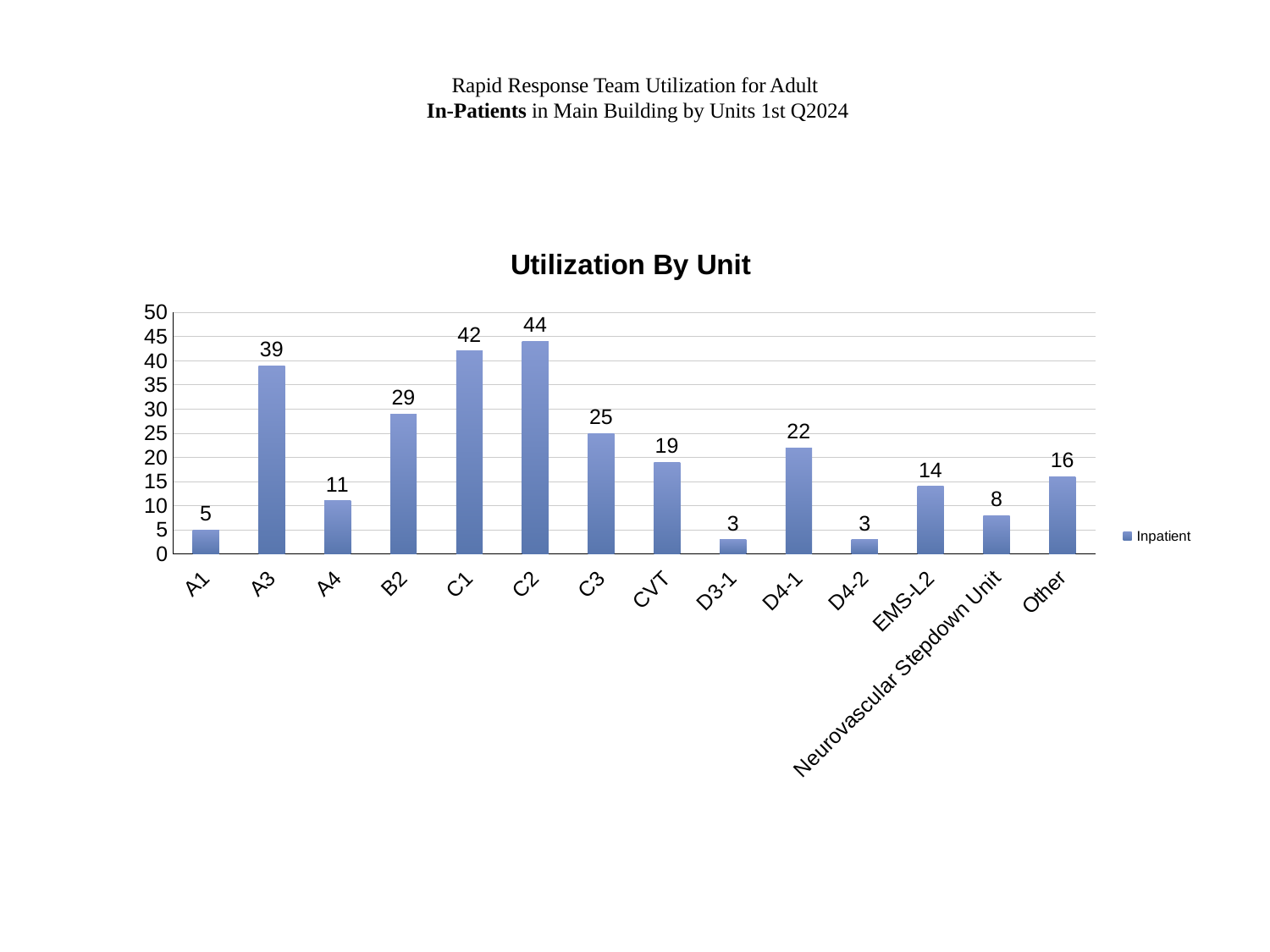
What is the value for EMS-L2? 14 What is the value for C1 in the Utilization By Unit chart? 42 Which units share the lowest value? D3-1 and D4-2 What is the title of the chart? Utilization By Unit Which unit has the highest value? C2 Which is larger, the value for B2 or the value for C3? B2 How many series does the legend list? 1 What is the difference between the values for C2 and A3? 5 What kind of chart is shown? bar chart What is the value for Neurovascular Stepdown Unit? 8 Is the value for CVT greater or less than 20? less How many units are shown on the x axis? 14